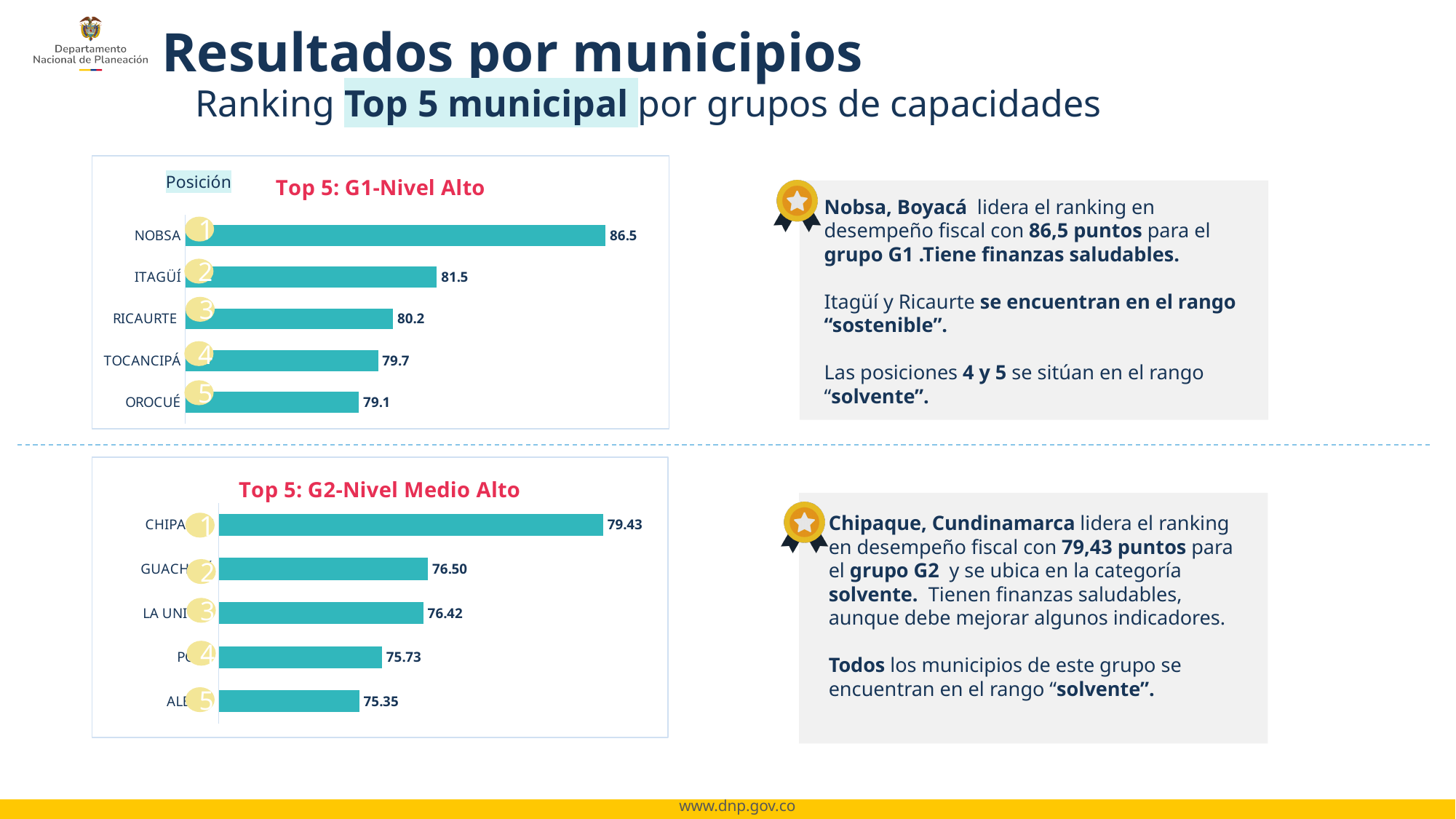
In the 'Top 5: G1-Nivel Alto' chart, which is larger, the value for TOCANCIPÁ or the value for RICAURTE? RICAURTE In the 'Top 5: G1-Nivel Alto' chart, what is the value for NOBSA? 86.5 How many municipalities are shown in the 'Top 5: G1-Nivel Alto' chart? 5 In the 'Top 5: G1-Nivel Alto' chart, what is the difference between the values for NOBSA and ITAGÜÍ? 5.0 In the 'Top 5: G1-Nivel Alto' chart, what is the value for OROCUÉ? 79.1 In the 'Top 5: G1-Nivel Alto' chart, what is the value for RICAURTE? 80.2 In the 'Top 5: G1-Nivel Alto' chart, which municipality has the highest value? NOBSA In the 'Top 5: G1-Nivel Alto' chart, which municipality has the lowest value? OROCUÉ In the 'Top 5: G2-Nivel Medio Alto' chart, what is the value of the bar in position 1? 79.43 What kind of chart is the 'Top 5: G2-Nivel Medio Alto' chart? Bar chart In the 'Top 5: G2-Nivel Medio Alto' chart, what is the difference between the values in position 2 and position 3? 0.08 In the 'Top 5: G2-Nivel Medio Alto' chart, what is the value of the bar in position 5? 75.35